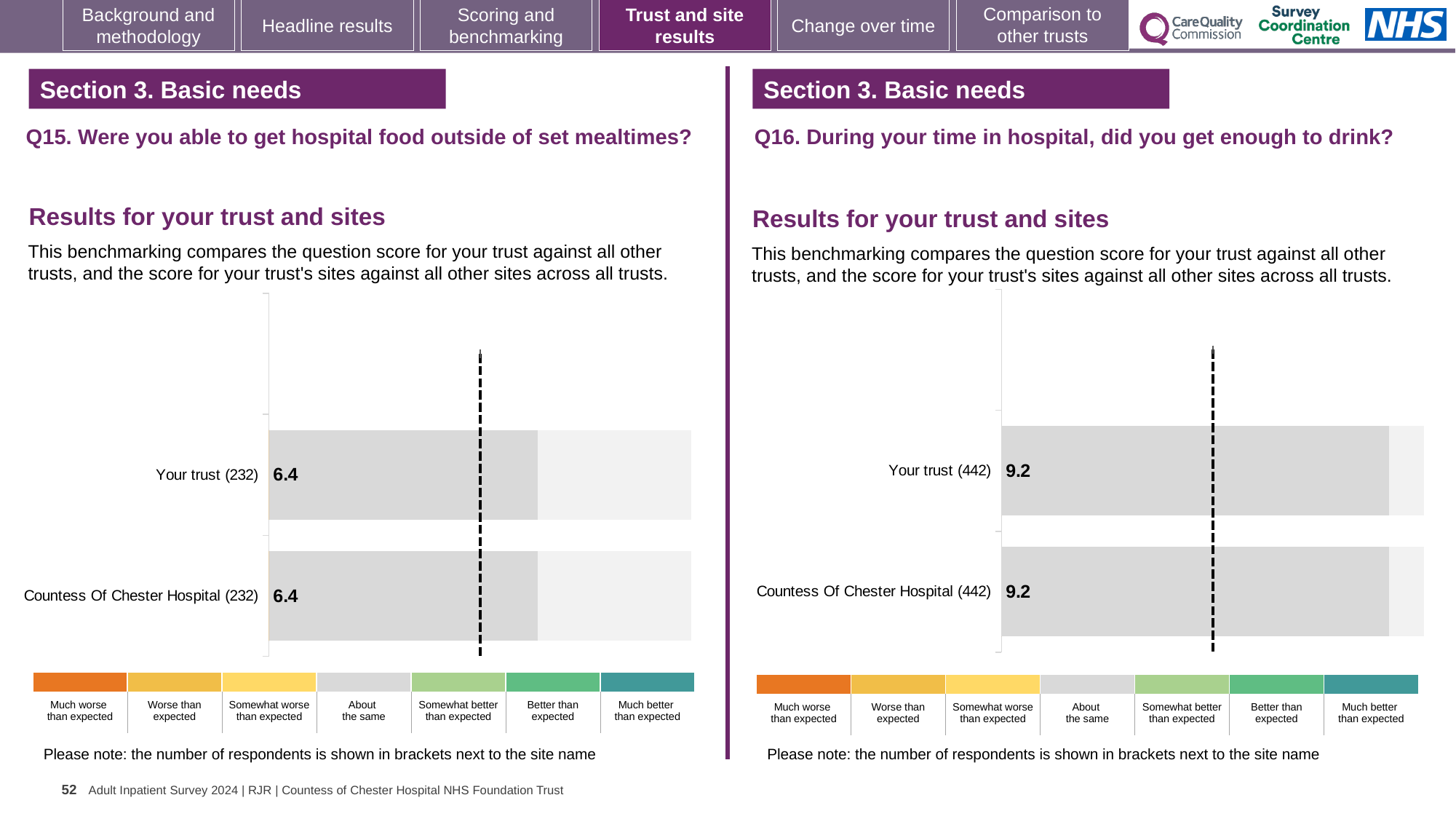
On the Q15 chart (left), how many respondents are shown in brackets next to Your trust? 232 On the Q15 chart (left), what is the score for Countess Of Chester Hospital? 6.4 On the Q16 chart (right), what is the score for Your trust? 9.2 What kind of chart is used on the Q15 chart (left)? Bar chart On the Q15 chart (left), what is the difference between the score for Your trust and the score for Countess Of Chester Hospital? 0 On the Q16 chart (right), what is the difference between the score for Your trust and the score for Countess Of Chester Hospital? 0 How many bars are plotted on the Q15 chart (left)? 2 Is the score for Your trust on the Q16 chart (right) larger or smaller than the score for Your trust on the Q15 chart (left)? Larger On the Q16 chart (right), how many respondents are shown in brackets next to Countess Of Chester Hospital? 442 On the Q16 chart (right), what is the score for Countess Of Chester Hospital? 9.2 How many bars are plotted on the Q16 chart (right)? 2 On the Q15 chart (left), what is the score for Your trust? 6.4